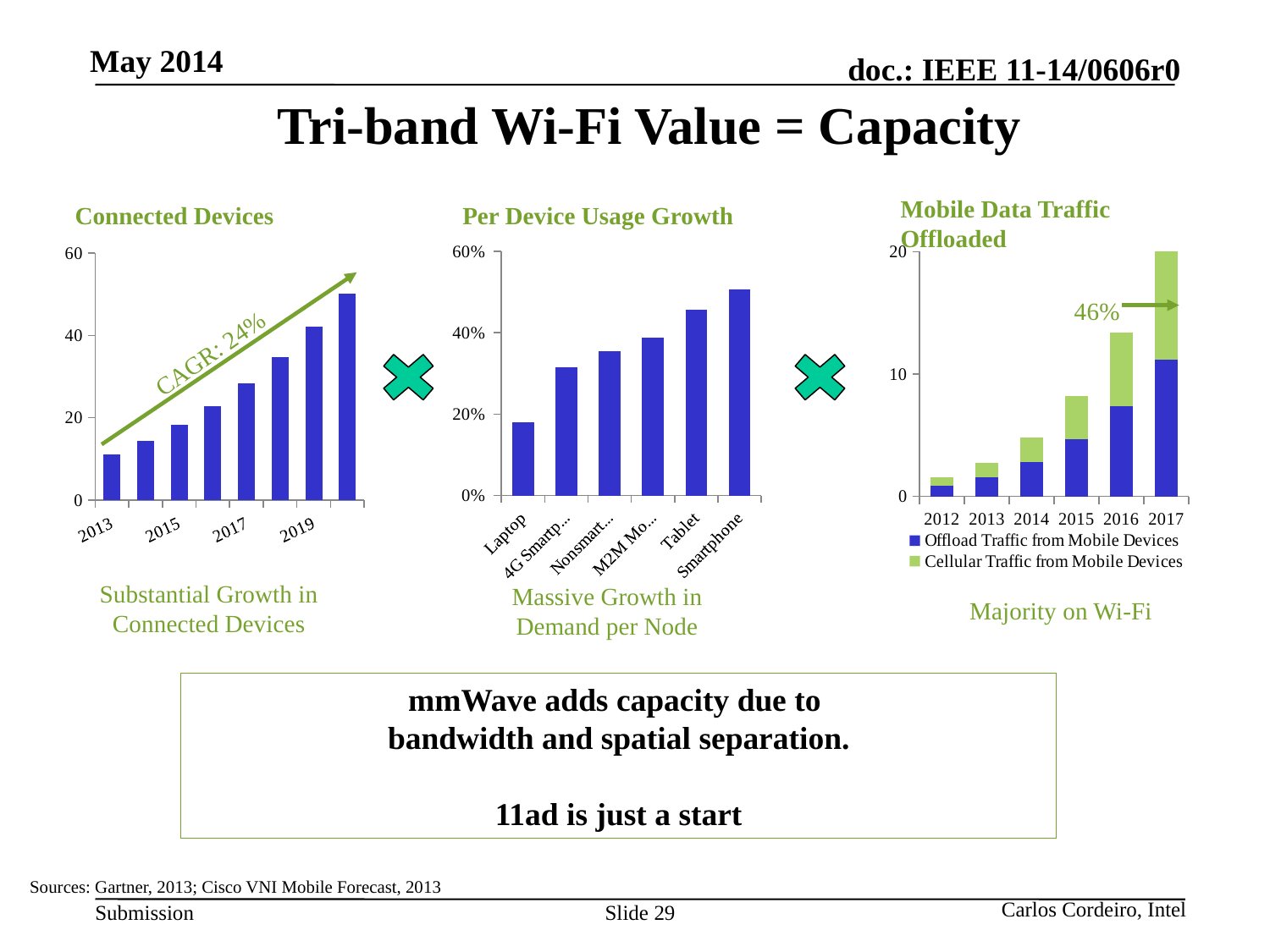
In the Connected Devices chart, is the value for 2013 greater or less than 20? less In the Per Device Usage Growth chart, is the value for Smartphone greater or less than 40%? greater In the Mobile Data Traffic Offloaded chart, which year has the tallest stacked bar? 2017 In the Per Device Usage Growth chart, is the value for Laptop greater or less than 20%? less How many series does the legend of the Mobile Data Traffic Offloaded chart list? 2 In the Connected Devices chart, do the values rise or fall from 2013 onward? rise In the Per Device Usage Growth chart, which category has the lowest value? Laptop What kind of chart is the Connected Devices chart? bar chart How many categories are plotted in the Per Device Usage Growth chart? 6 In the Per Device Usage Growth chart, which category has the highest value? Smartphone What CAGR is annotated on the Connected Devices chart? 24%